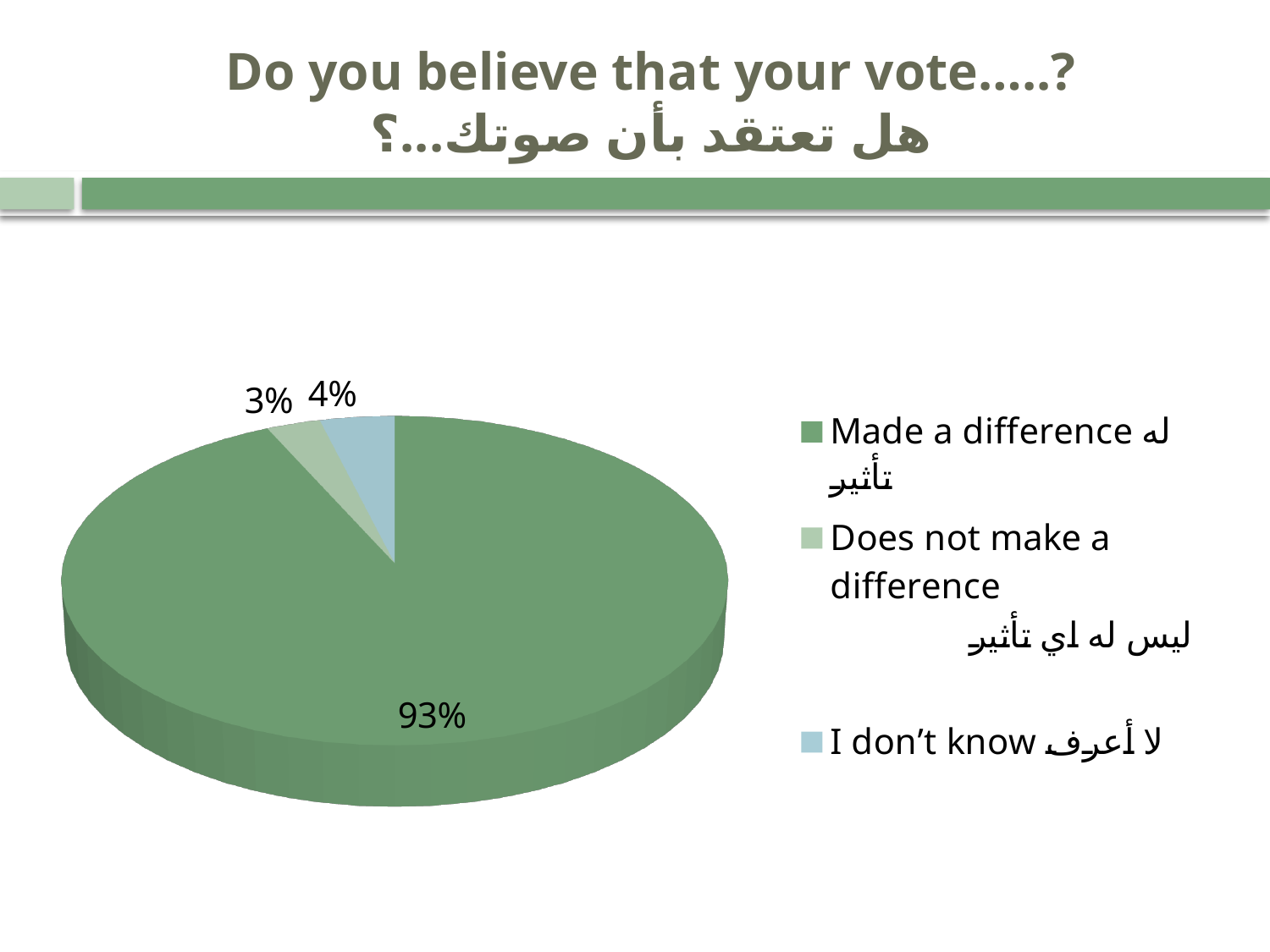
What is the combined share of "Does not make a difference" and "I don't know"? 7% What is the difference in percentage points between "Made a difference" and "I don't know"? 89 What kind of chart is shown on the slide? pie chart How many slices does the pie chart have? 3 Which response has the smallest slice of the pie? Does not make a difference What colour is the "I don't know" slice in the pie chart? light blue Which response has the largest slice of the pie? Made a difference How many entries does the legend list? 3 What share of respondents answered "I don't know"? 4% What share of respondents said their vote "Does not make a difference"? 3% What share of respondents said their vote "Made a difference"? 93% Which is larger, the share for "I don't know" or the share for "Does not make a difference"? I don't know